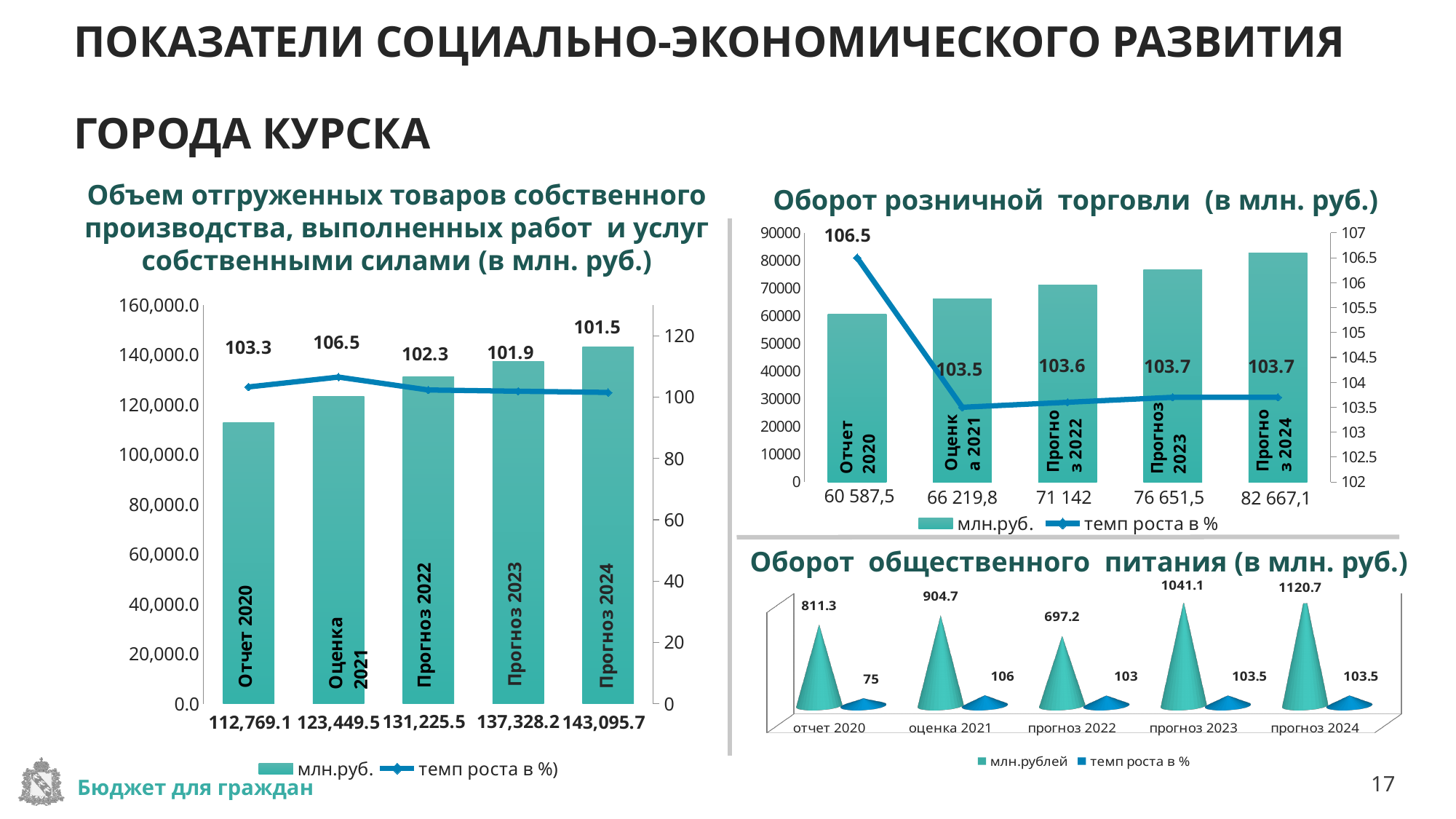
In the chart 'Объем отгруженных товаров собственного производства...', do the bar values rise or fall from Отчет 2020 to Прогноз 2024? rise In the chart 'Объем отгруженных товаров собственного производства...', which category has the lowest value in млн.руб.? Отчет 2020 In the chart 'Оборот розничной торговли (в млн. руб.)', which category has the highest темп роста в %? Отчет 2020 In the chart 'Объем отгруженных товаров собственного производства...', what is the темп роста в % for Оценка 2021? 106.5 In the chart 'Оборот общественного питания (в млн. руб.)', what is the difference in млн.рублей between прогноз 2024 and прогноз 2023? 79.6 In the chart 'Объем отгруженных товаров собственного производства...', what is the value in млн.руб. for Прогноз 2024? 143,095.7 In the chart 'Оборот розничной торговли (в млн. руб.)', how many categories are shown on the x axis? 5 In the chart 'Оборот общественного питания (в млн. руб.)', which category has the lowest темп роста в %? отчет 2020 In the chart 'Оборот общественного питания (в млн. руб.)', what is the value in млн.рублей for прогноз 2022? 697.2 In the chart 'Оборот розничной торговли (в млн. руб.)', what is the value for Прогноз 2022? 71 142 In the chart 'Оборот общественного питания (в млн. руб.)', how many series does the legend list? 2 In the chart 'Оборот розничной торговли (в млн. руб.)', what is the темп роста в % for Отчет 2020? 106.5